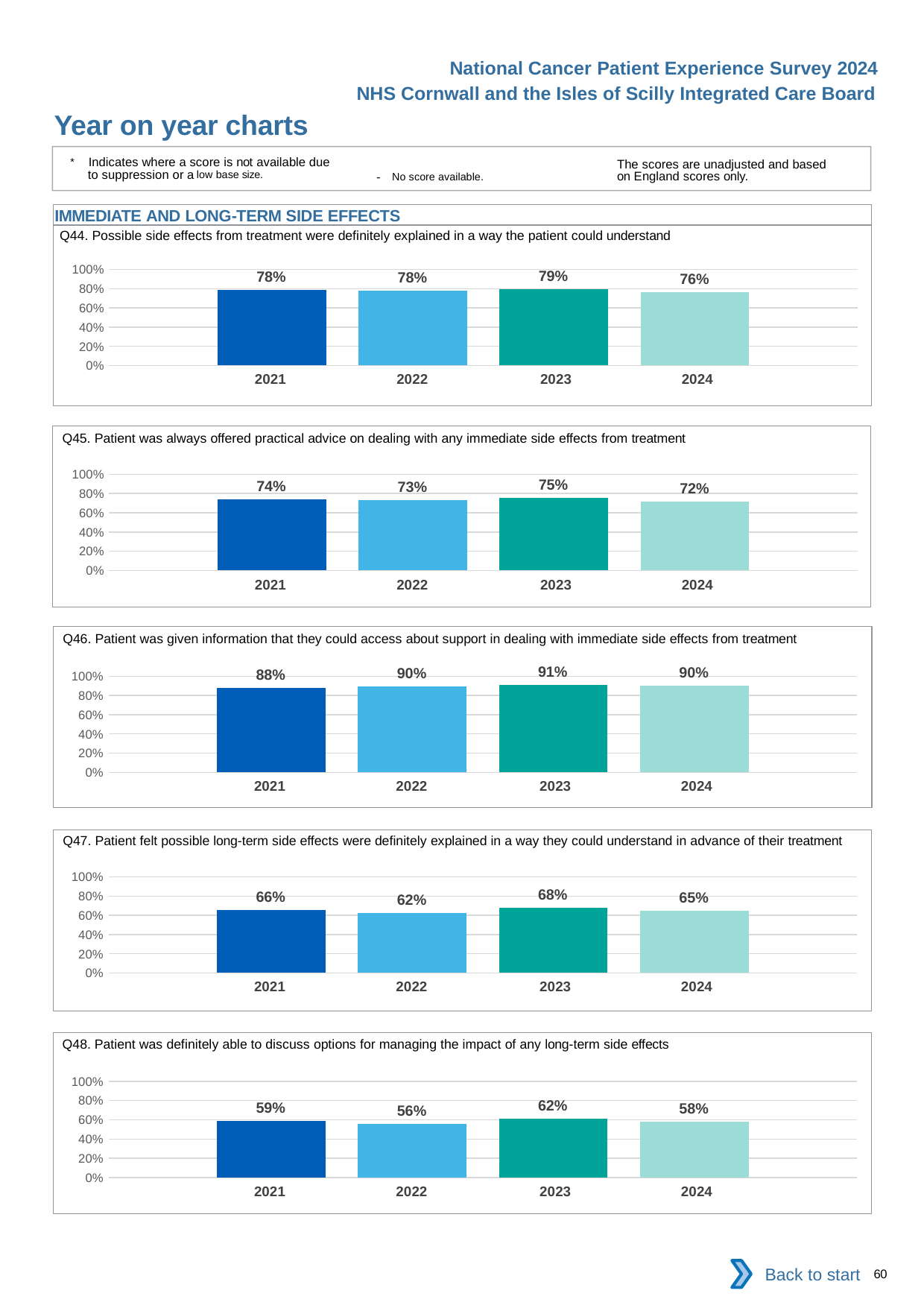
In the Q47 chart, which is larger, the value for 2021 or the value for 2022? 2021 In the Q48 chart, what is the difference between the 2023 and 2022 values? 6 percentage points In the Q44 chart, which year has the lowest value? 2024 In the Q44 chart, what is the value for 2023? 79% In the Q45 chart, what is the value for 2024? 72% How many years are shown in the Q48 chart? 4 What type of chart is the Q44 chart? Bar chart In the Q48 chart, which year has the lowest value? 2022 In the Q46 chart, what is the value for 2021? 88% In the Q46 chart, which year has the highest value? 2023 In the Q47 chart, what is the value for 2023? 68% In the Q45 chart, what is the difference between the 2023 and 2024 values? 3 percentage points